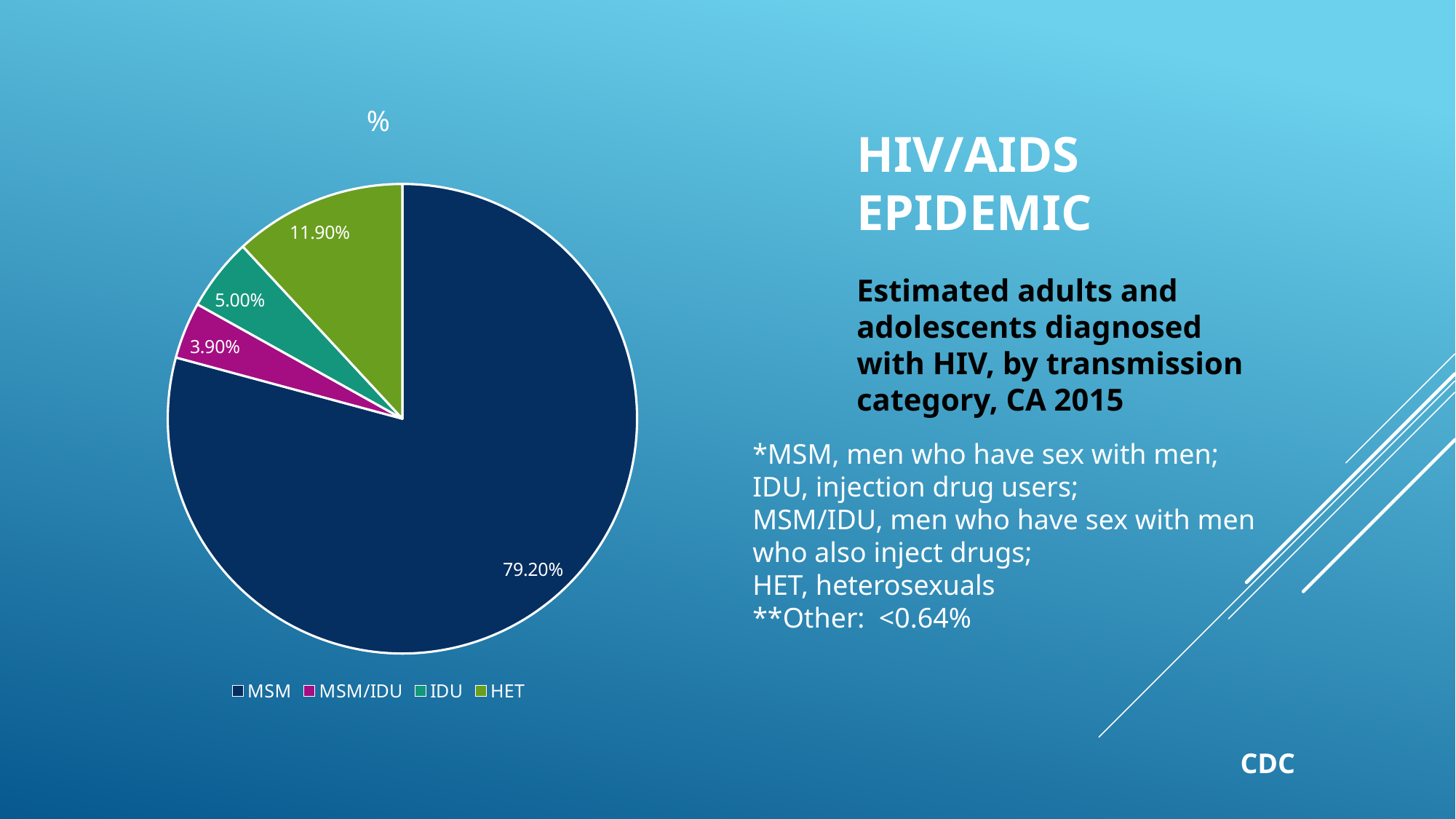
How many categories does the pie chart show? 4 Which category has the largest slice? MSM What is the title of the chart? % What is the value for MSM? 79.20% What is the difference between the values for HET and IDU? 6.90% Which category has the smallest slice? MSM/IDU What is the value for HET? 11.90% Which is larger, the value for IDU or the value for MSM/IDU? IDU What is the value for MSM/IDU? 3.90% What is the value for IDU? 5.00% What kind of chart is shown on the slide? pie chart What colour is the HET slice? green